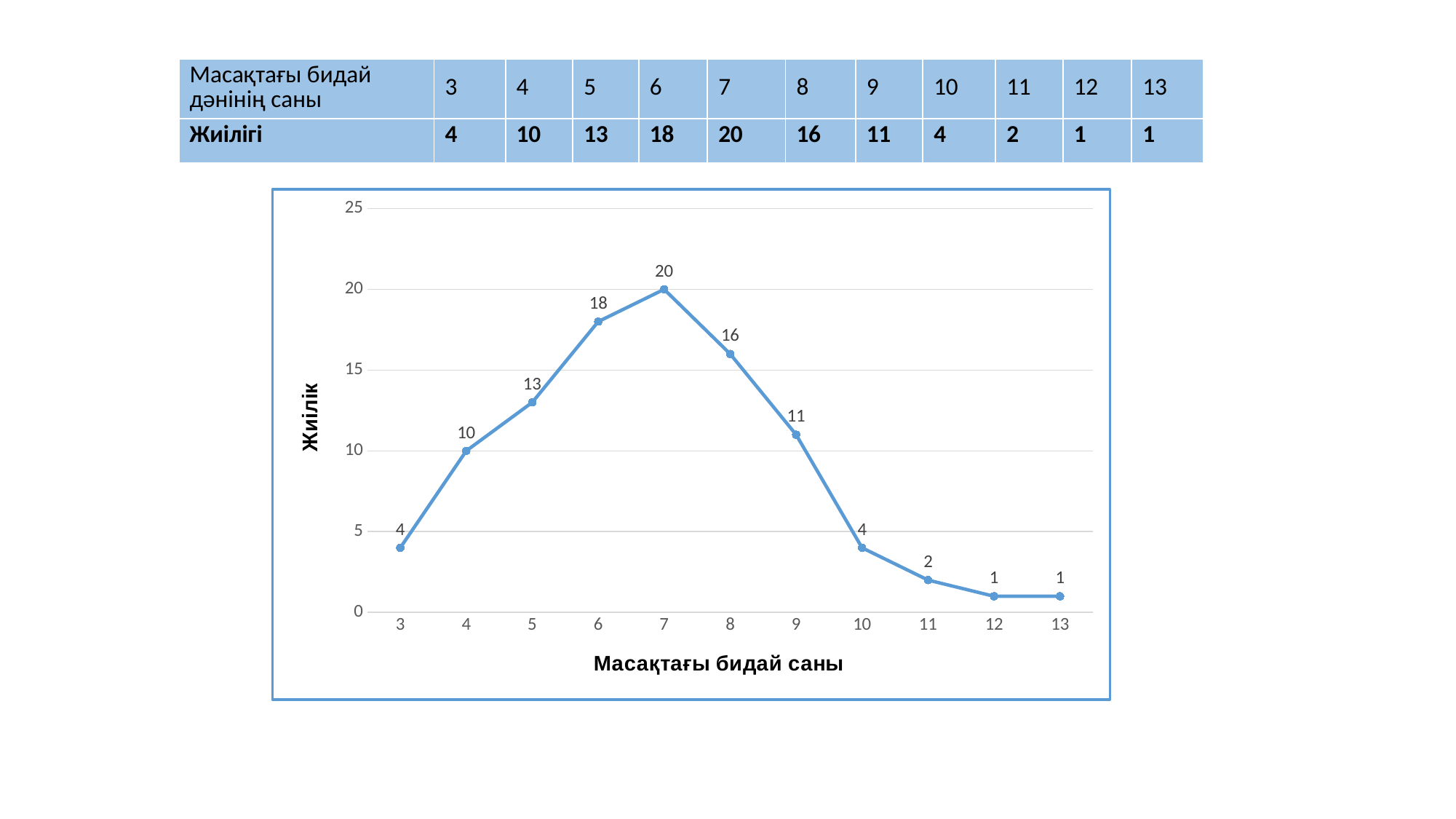
What is the frequency value at x = 5? 13 At which x value is the frequency highest? 7 What type of chart is shown on the slide? line chart What is the frequency (Жиілік) value at x = 7? 20 What is the lowest frequency value plotted on the chart? 1 What is the label of the x axis? Масақтағы бидай саны Is the frequency at x = 4 greater or less than 15? less How many data points are plotted on the line? 11 Which has a larger frequency, x = 6 or x = 8? 6 What is the frequency value at x = 10? 4 What is the difference between the frequency at x = 7 and the frequency at x = 9? 9 Does the frequency rise or fall from x = 7 to x = 13? fall